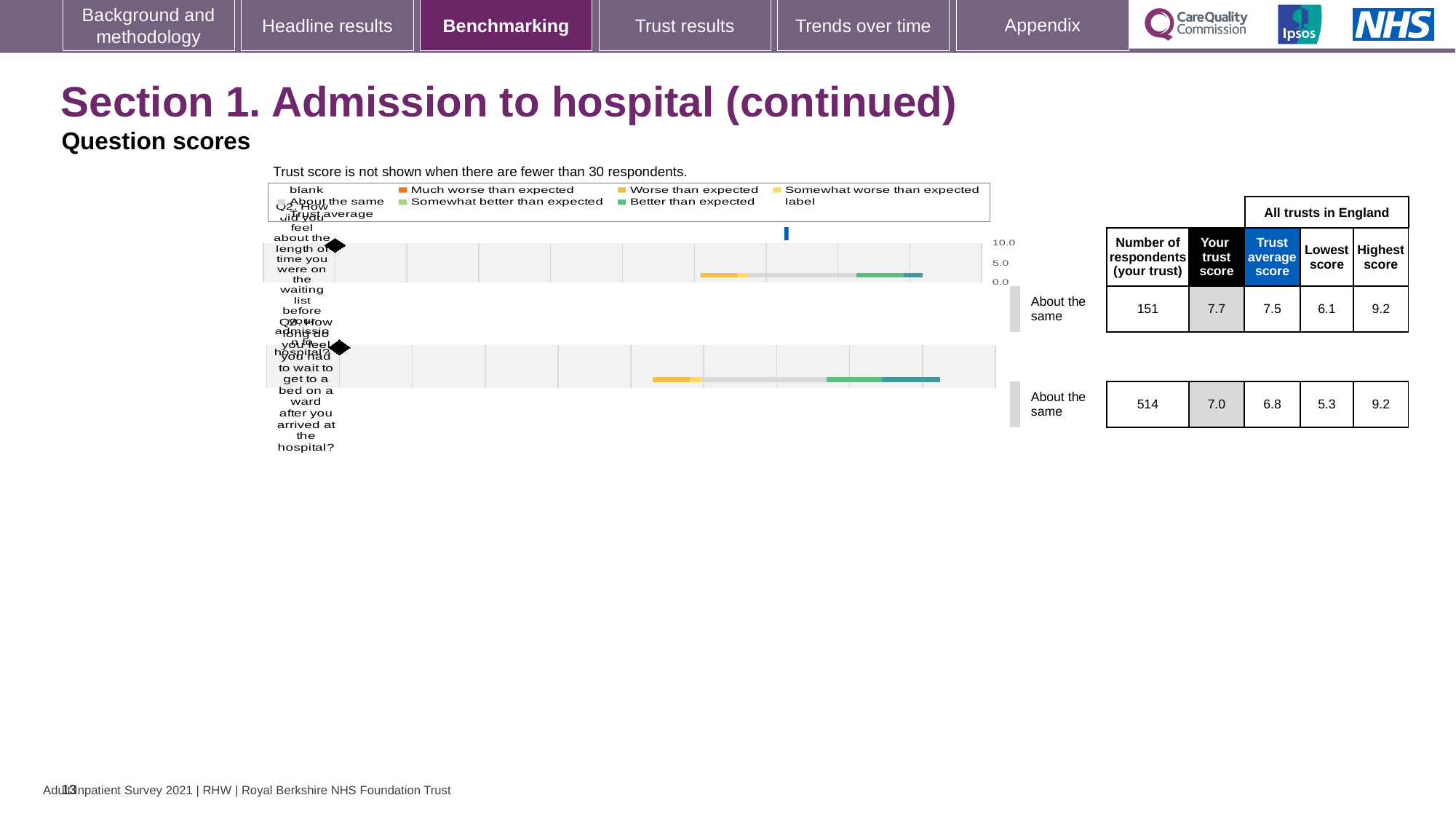
What is the highest score among all trusts in England for Q2? 9.2 Which question has the higher trust score, Q2 or Q3? Q2 What is the trust average score across all trusts in England for Q2? 7.5 What is the lowest score among all trusts in England for Q3? 5.3 How many respondents answered Q2 for this trust? 151 How many respondents answered Q3 for this trust? 514 How many questions are plotted on the slide? 2 What is the trust score for Q3 (how long did you feel you had to wait to get to a bed on a ward)? 7.0 What kind of chart is used to show the question scores? Bar chart By how much does the trust score for Q3 exceed the all-trusts average score for Q3? 0.2 What benchmark category is shown for Q3's trust score? About the same What is the trust score for Q2 (how did you feel about the length of time you were on the waiting list before admission)? 7.7